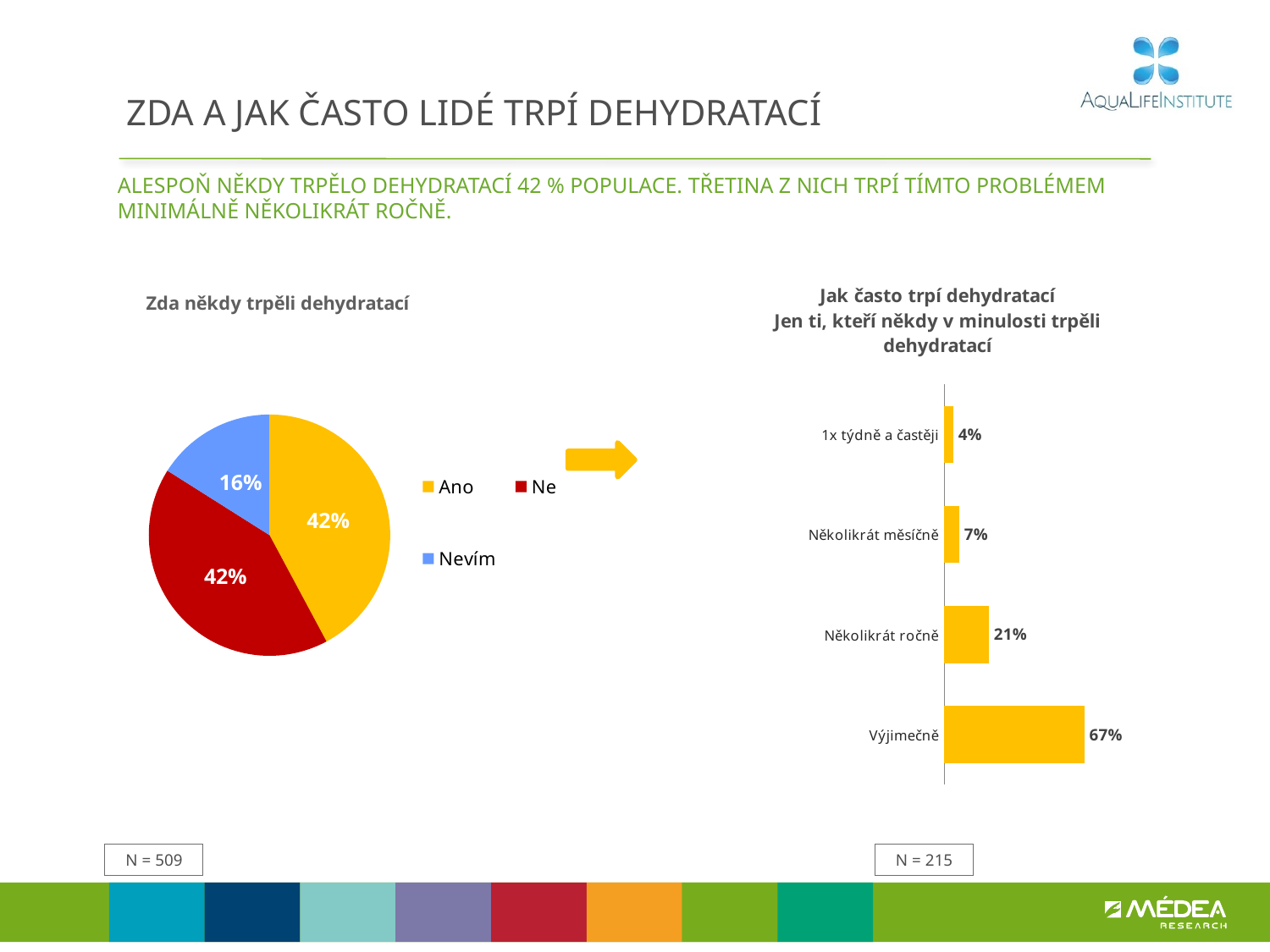
In the bar chart 'Jak často trpí dehydratací', which category has the lowest value? 1x týdně a častěji In the pie chart 'Zda někdy trpěli dehydratací', how many slices are there? 3 In the bar chart 'Jak často trpí dehydratací', what is the difference between 'Výjimečně' and 'Několikrát ročně'? 46% In the pie chart 'Zda někdy trpěli dehydratací', what share is labelled 'Nevím'? 16% In the bar chart 'Jak často trpí dehydratací', which category has the highest value? Výjimečně What type of chart is the left chart titled 'Zda někdy trpěli dehydratací'? Pie chart In the pie chart 'Zda někdy trpěli dehydratací', which slice is the smallest? Nevím In the pie chart 'Zda někdy trpěli dehydratací', what share is labelled 'Ano'? 42% In the bar chart 'Jak často trpí dehydratací', what is the value for 'Několikrát měsíčně'? 7% What type of chart is the right chart titled 'Jak často trpí dehydratací'? Bar chart In the bar chart 'Jak často trpí dehydratací', what is the value for 'Výjimečně'? 67% In the pie chart 'Zda někdy trpěli dehydratací', what is the difference between the 'Ano' share and the 'Nevím' share? 26%